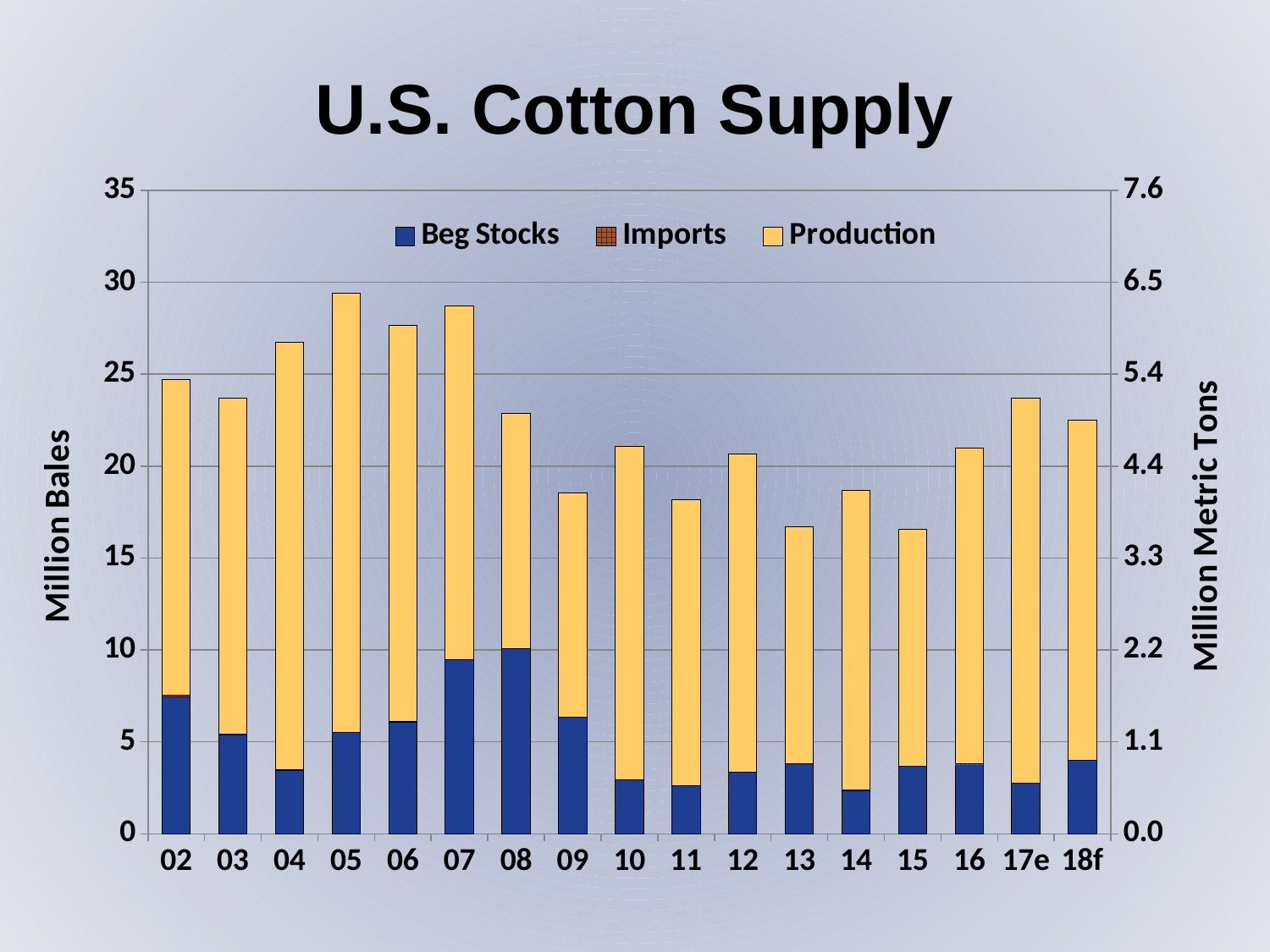
Is the Beg Stocks value for 07 greater or less than 5 million bales? greater Is the total supply for 05 greater or less than 25 million bales? greater Is the total supply for 13 greater or less than 20 million bales? less What is the label on the left vertical axis? Million Bales What type of chart is shown on the slide? Stacked bar chart Which year has the larger total supply, 05 or 13? 05 From 15 to 17e, do the total supply bars rise or fall? rise How many series does the legend list? 3 Which year has the highest total supply bar? 05 How many years (categories) are shown on the x axis? 17 Which year has the tallest Beg Stocks segment? 08